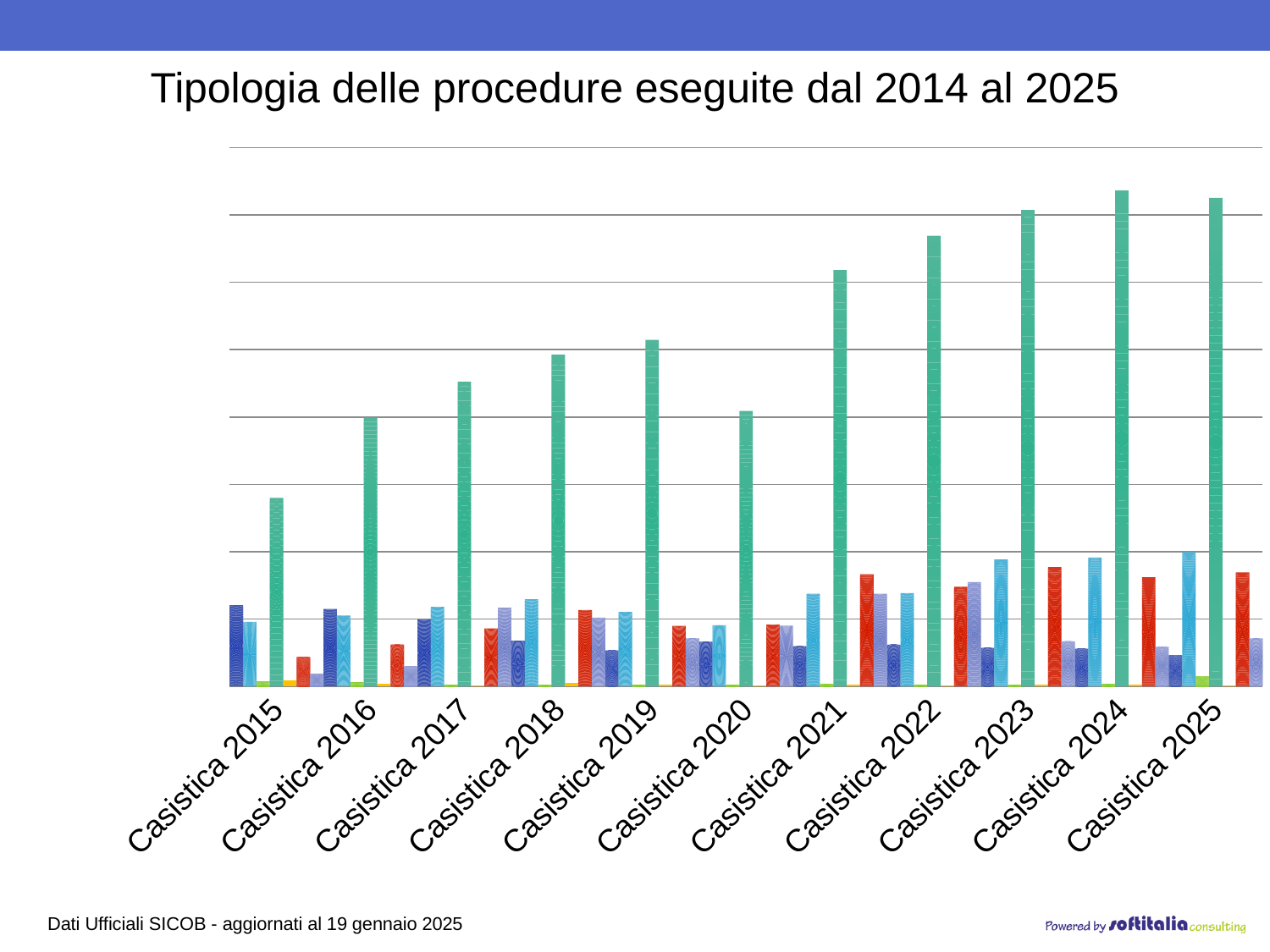
Is the green bar for Casistica 2021 or Casistica 2020 taller? Casistica 2021 What is the first category label on the x axis? Casistica 2015 What kind of chart is shown on the slide? bar chart Which category has the lowest green bar? Casistica 2015 Is the green bar for Casistica 2016 or Casistica 2017 taller? Casistica 2017 What is the title of the chart? Tipologia delle procedure eseguite dal 2014 al 2025 Is the red bar for Casistica 2023 or Casistica 2016 taller? Casistica 2023 How many categories are shown along the x axis of the chart? 11 Do the green bars generally rise or fall from Casistica 2015 to Casistica 2025? rise